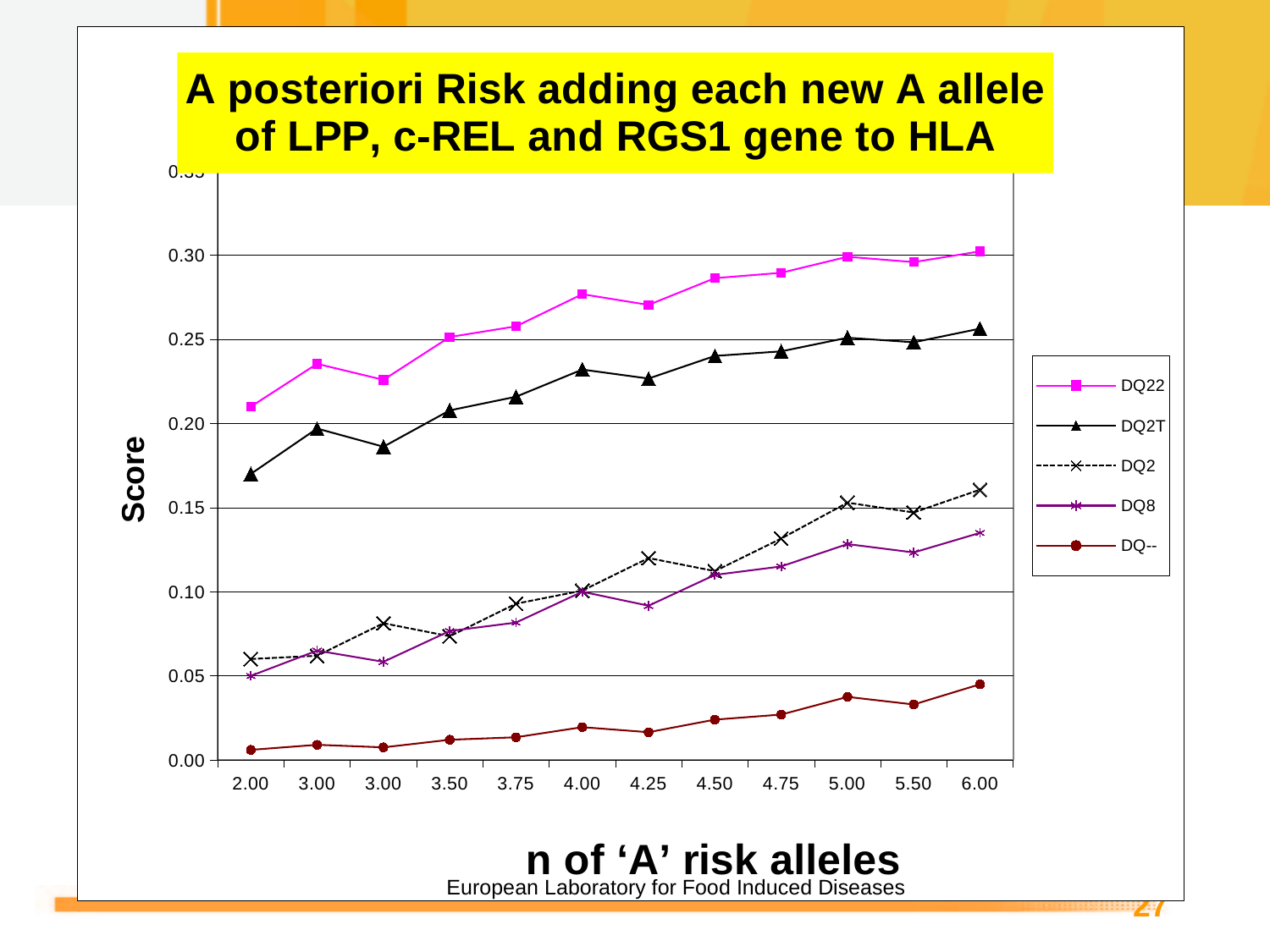
What kind of chart is shown on the slide? line chart Is the DQ2 score at 4.25 risk alleles greater or less than 0.10? greater How many points are plotted along the x axis for each series? 12 Is the DQ8 score at 6.00 risk alleles greater or less than 0.15? less How many series does the legend list? 5 At 4.00 risk alleles, which series has the larger score, DQ22 or DQ2T? DQ22 Which series has the highest score at 6.00 risk alleles? DQ22 Is the DQ22 score at 2.00 risk alleles greater or less than 0.20? greater Does the DQ22 score generally rise or fall as the number of 'A' risk alleles increases? rise Which series has the lowest score across the chart? DQ-- What is the label of the y axis? Score At 6.00 risk alleles, which series has the larger score, DQ2 or DQ8? DQ2